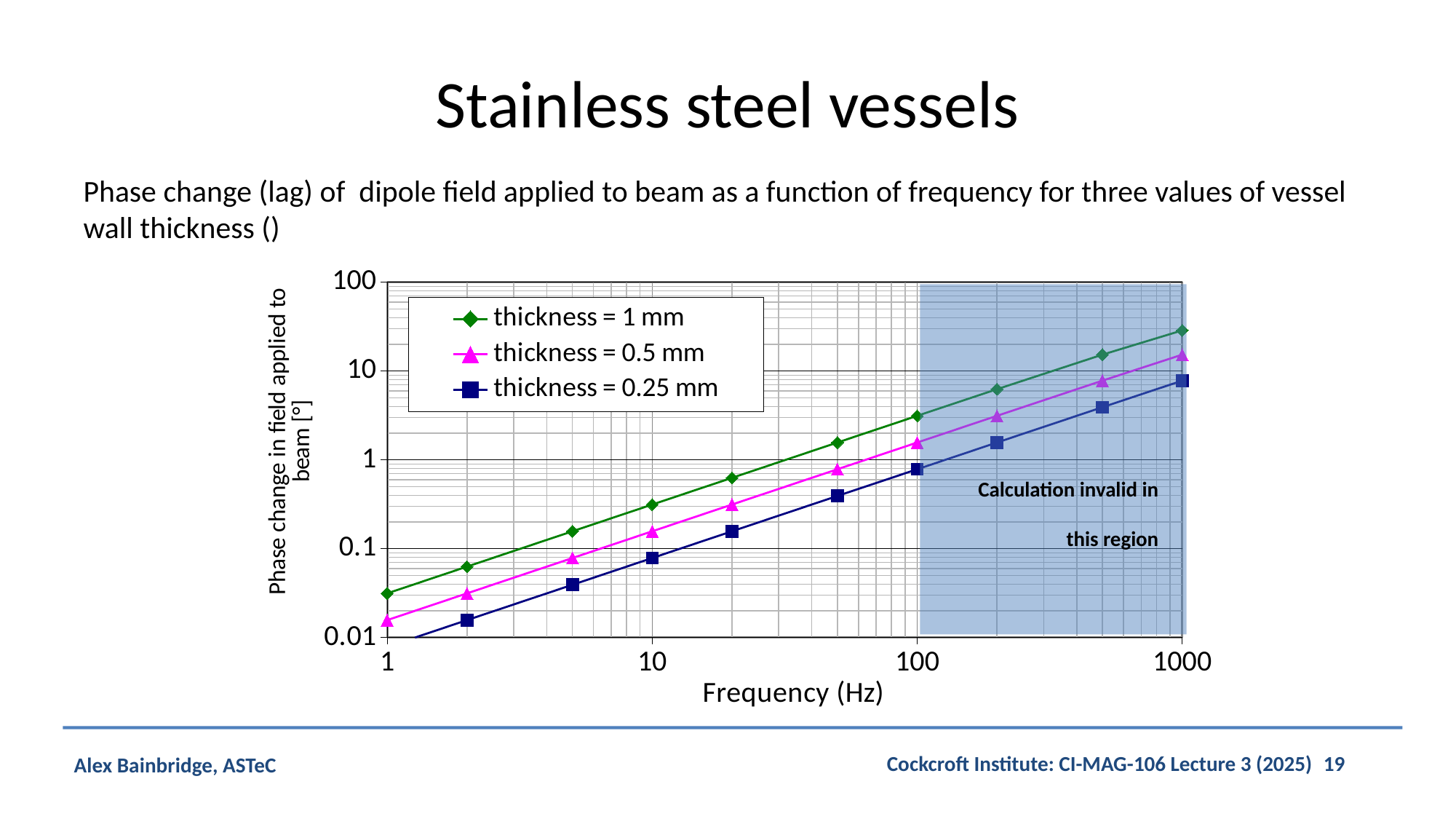
Does the phase change rise or fall as frequency increases? Rise Is the value for thickness = 0.25 mm at 10 Hz greater or less than 0.1? less How many data points are plotted for the thickness = 1 mm series? 10 Is the value for thickness = 1 mm at 100 Hz greater or less than 1? greater How many series does the legend list? 3 Is the value for thickness = 0.25 mm at 1000 Hz greater or less than 10? less Which series has the lowest phase change at every frequency? thickness = 0.25 mm At 100 Hz, which is larger: the value for thickness = 1 mm or thickness = 0.25 mm? thickness = 1 mm What kind of chart is shown on the slide? Line chart Which series has the highest phase change at every frequency? thickness = 1 mm What does the shaded region on the right of the chart indicate? Calculation invalid in this region